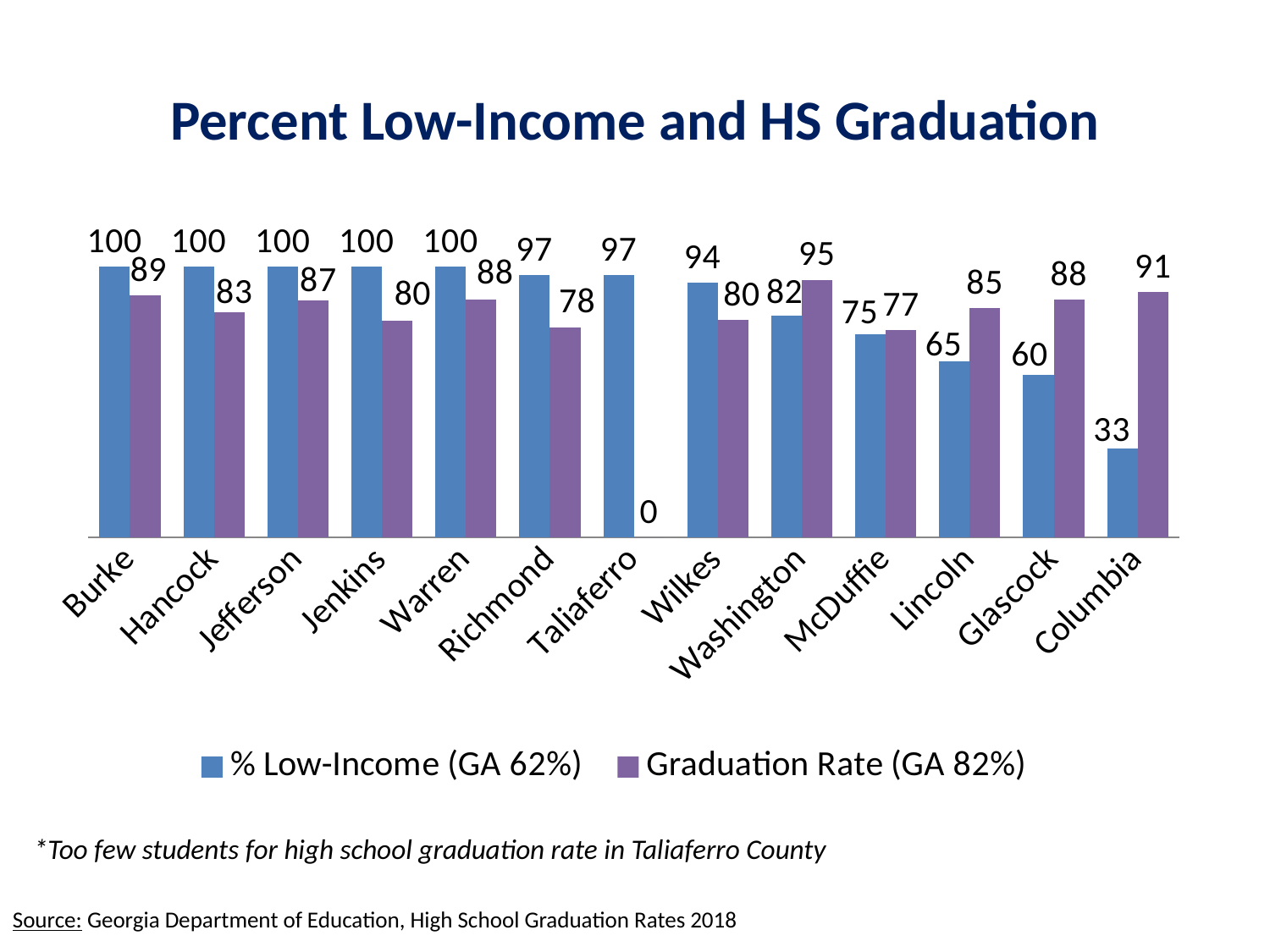
For Lincoln, which is larger: the % Low-Income value or the Graduation Rate? Graduation Rate What is the Graduation Rate for Washington? 95 What is the difference between the Graduation Rate and the % Low-Income value for Columbia? 58 Which county has the highest Graduation Rate? Washington What is the % Low-Income value for Columbia? 33 What is the Graduation Rate for Richmond? 78 What kind of chart is shown on the slide? Bar chart Do the % Low-Income values rise or fall from left to right across the counties? Fall Which county has the lowest % Low-Income value? Columbia What is the difference between the Graduation Rate and the % Low-Income value for Glascock? 28 How many series does the legend list? 2 How many counties are shown on the x axis? 13